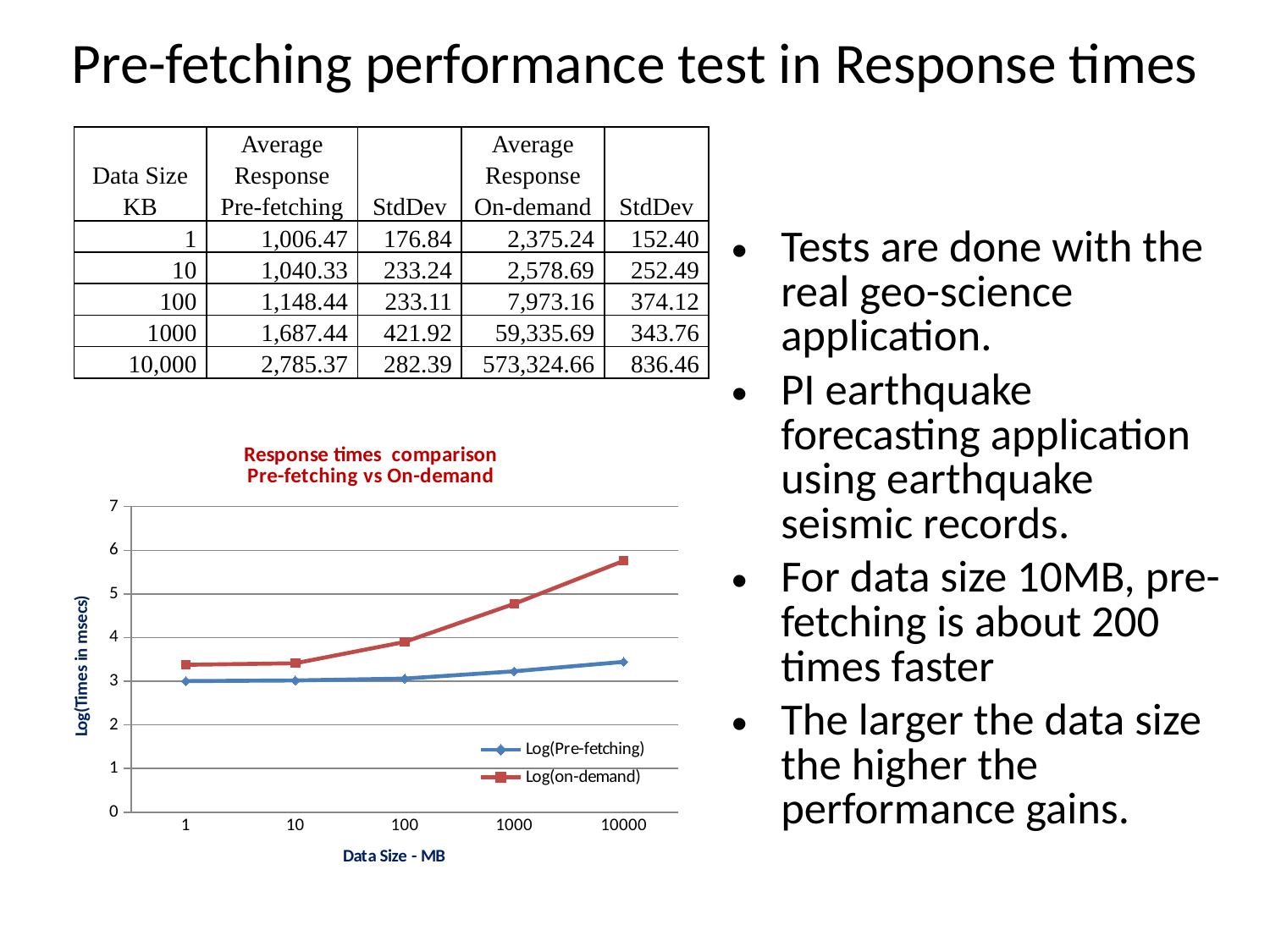
At which data size does the Log(on-demand) series reach its highest value? 10000 Does the Log(on-demand) series rise or fall as data size increases along the x axis? rise How many series does the chart legend list? 2 How many data size values are plotted along the x axis of the chart? 5 Is the value of Log(on-demand) at data size 10000 greater or less than 5? greater What is the label of the chart's y axis? Log(Times in msecs) What kind of chart is shown on the slide? line chart Is the value of Log(Pre-fetching) at data size 10000 greater or less than 4? less Is the value of Log(on-demand) at data size 1000 greater or less than 4? greater At data size 10000, which series has the larger value, Log(Pre-fetching) or Log(on-demand)? Log(on-demand) What is the title of the chart? Response times comparison Pre-fetching vs On-demand